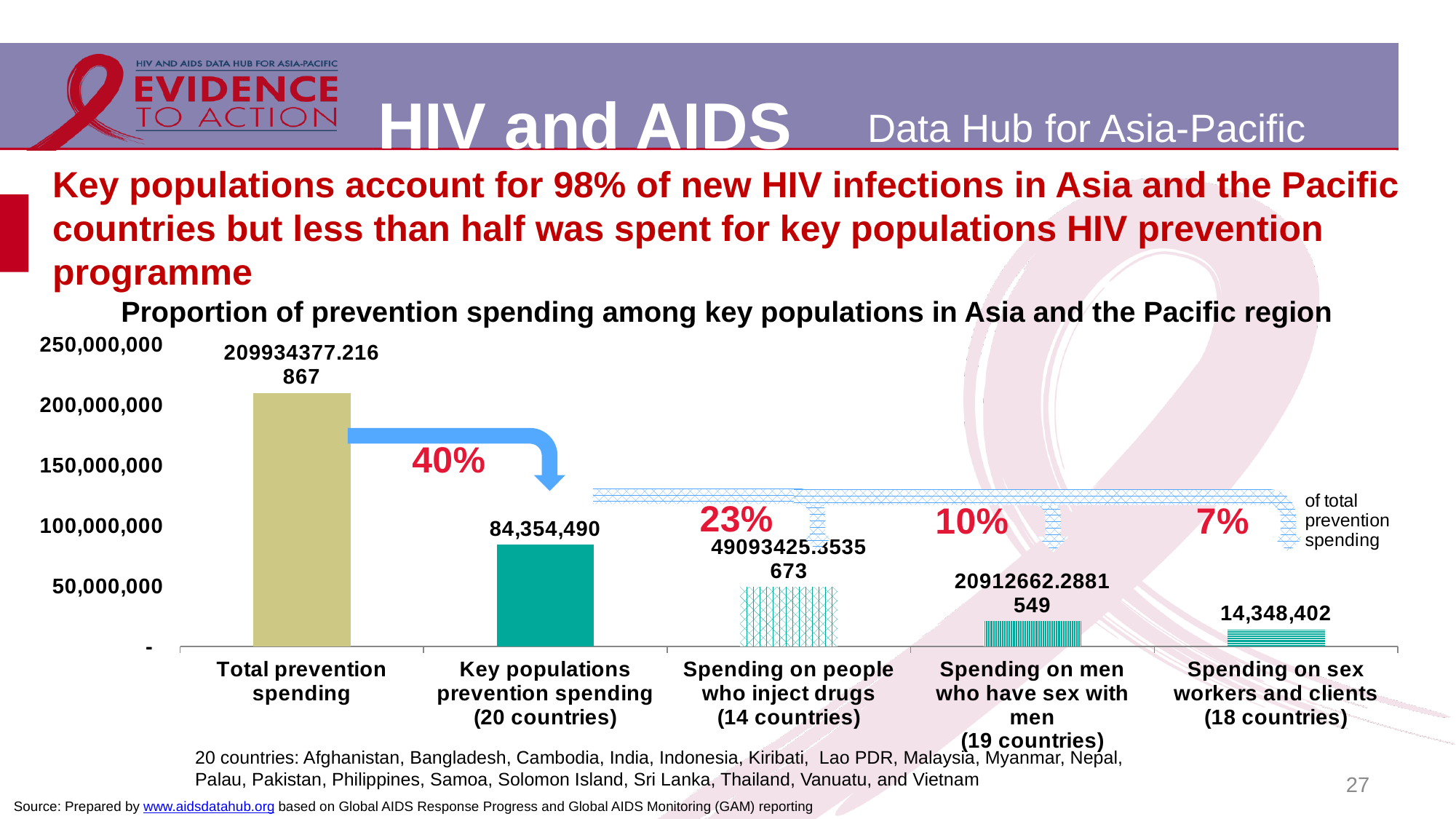
What kind of chart is shown on the slide? bar chart Which category has the lowest value? Spending on sex workers and clients (18 countries) Which is larger: Key populations prevention spending or Spending on people who inject drugs? Key populations prevention spending Is the value for Total prevention spending greater or less than 200,000,000? greater What is the difference between Key populations prevention spending (84,354,490) and Spending on sex workers and clients (14,348,402)? 70,006,088 Which category has the highest value? Total prevention spending What percentage of total prevention spending is shown for Spending on men who have sex with men? 10% What is the value for Key populations prevention spending (20 countries)? 84,354,490 What is the value for Spending on sex workers and clients (18 countries)? 14,348,402 What is the value labelled for Total prevention spending? 209934377.216867 How many categories are plotted on the x axis of the chart? 5 Is the value for Spending on men who have sex with men greater or less than 50,000,000? less